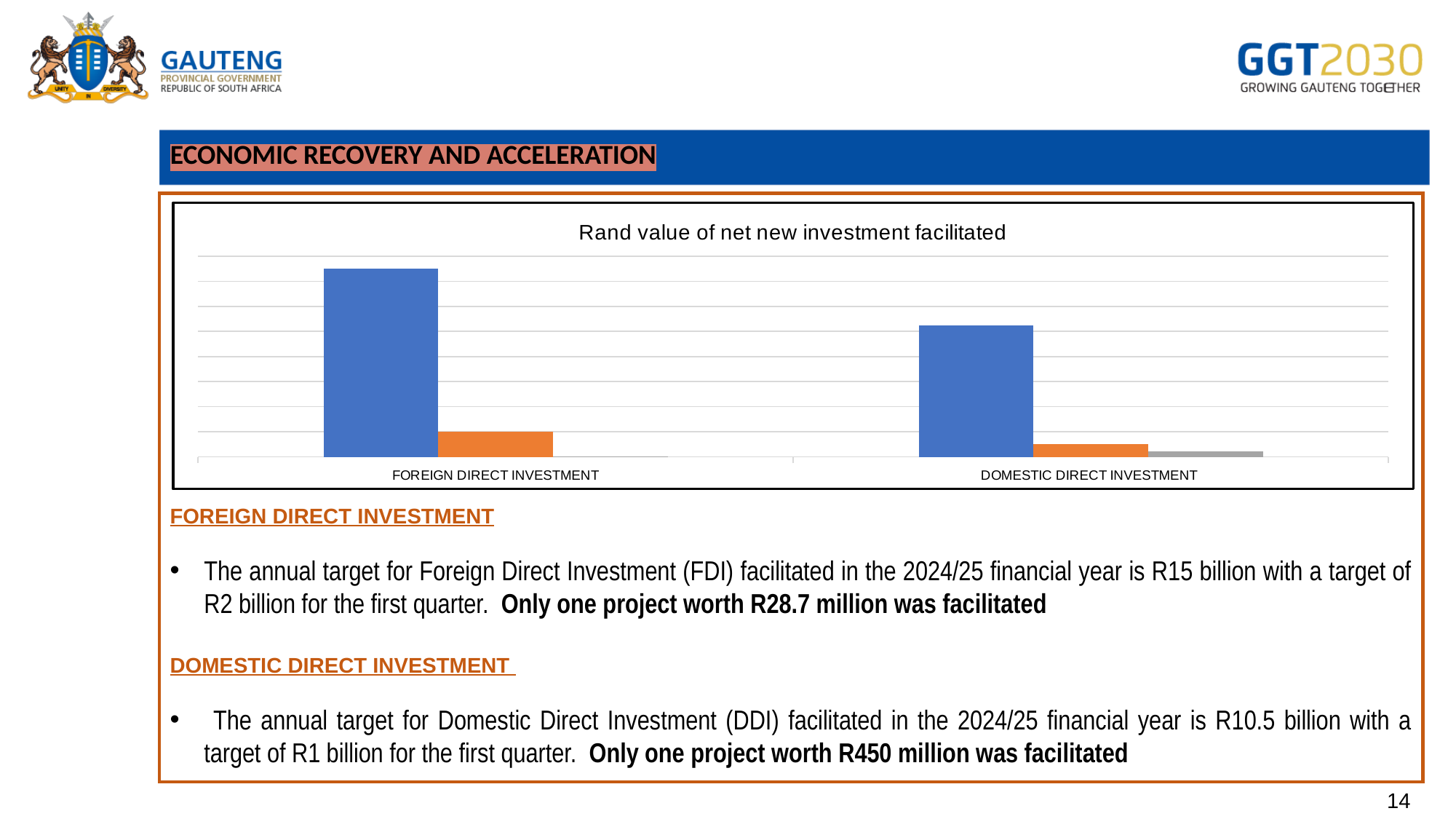
Within the Foreign Direct Investment category, which bar is taller, the blue one or the orange one? the blue one Within the Domestic Direct Investment category, which bar is the shortest? the grey bar Which category has the taller blue bar, Foreign Direct Investment or Domestic Direct Investment? Foreign Direct Investment What is the title of the chart? Rand value of net new investment facilitated Does the height of the blue bars rise or fall from Foreign Direct Investment to Domestic Direct Investment? fall How many categories are shown on the x axis of the chart? 2 What are the two category labels on the x axis of the chart? Foreign Direct Investment and Domestic Direct Investment What kind of chart is shown on the slide? bar chart Which category has the taller orange bar, Foreign Direct Investment or Domestic Direct Investment? Foreign Direct Investment